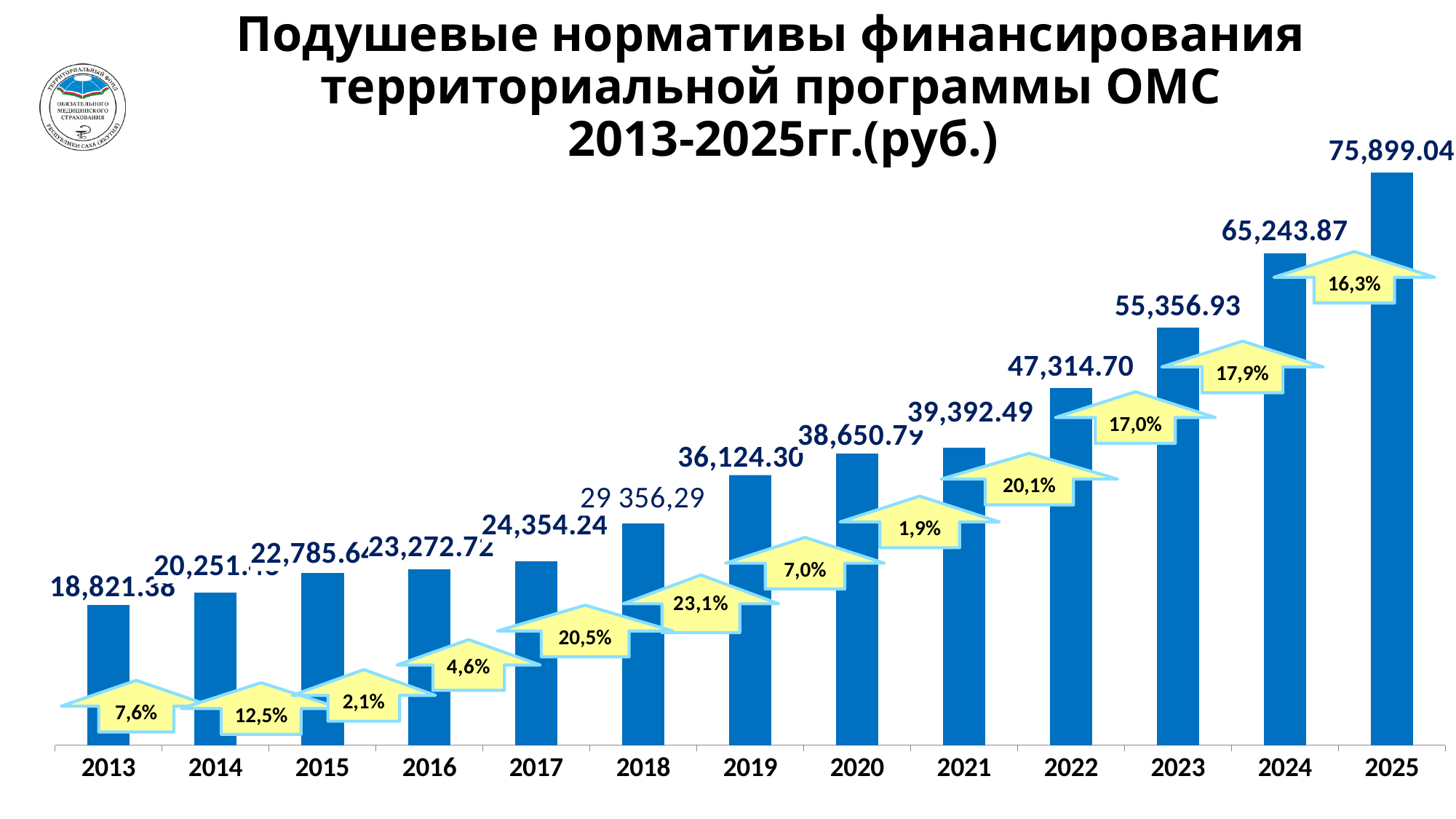
What kind of chart is this? bar chart What is the value for 2017? 24,354.24 Which year has the highest value? 2025 Which year has the lowest value? 2013 What is the value for 2025? 75,899.04 How many years are shown on the x axis? 13 What is the value for 2022? 47,314.70 What is the difference between the values for 2025 and 2024? 10,655.17 Which is larger, the value for 2021 or the value for 2023? 2023 What is the value for 2024? 65,243.87 What is the value for 2019? 36,124.30 Do the values rise or fall from 2013 to 2025? rise